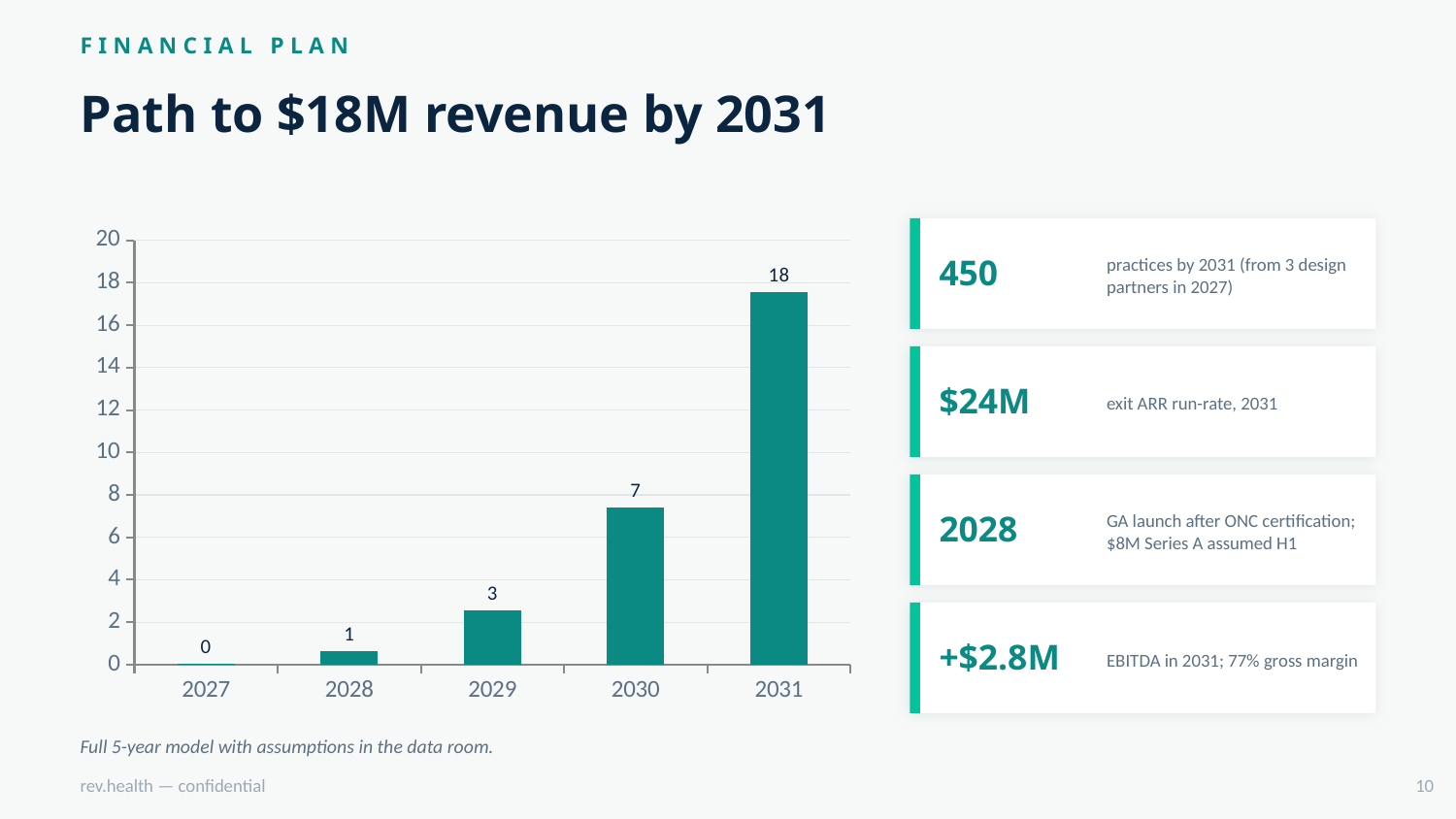
What is the value shown for 2030? 7 What kind of chart is shown on the slide? bar chart What is the value shown for 2029? 3 What is the difference between the values for 2031 and 2030? 11 Which year has the lowest value in the chart? 2027 How many years are shown on the x axis of the chart? 5 What is the value shown for 2031? 18 Is the value for 2031 greater or less than 16? greater What is the value shown for 2027? 0 Which year has the highest value in the chart? 2031 What is the value shown for 2028? 1 Which is larger, the value for 2029 or the value for 2030? 2030